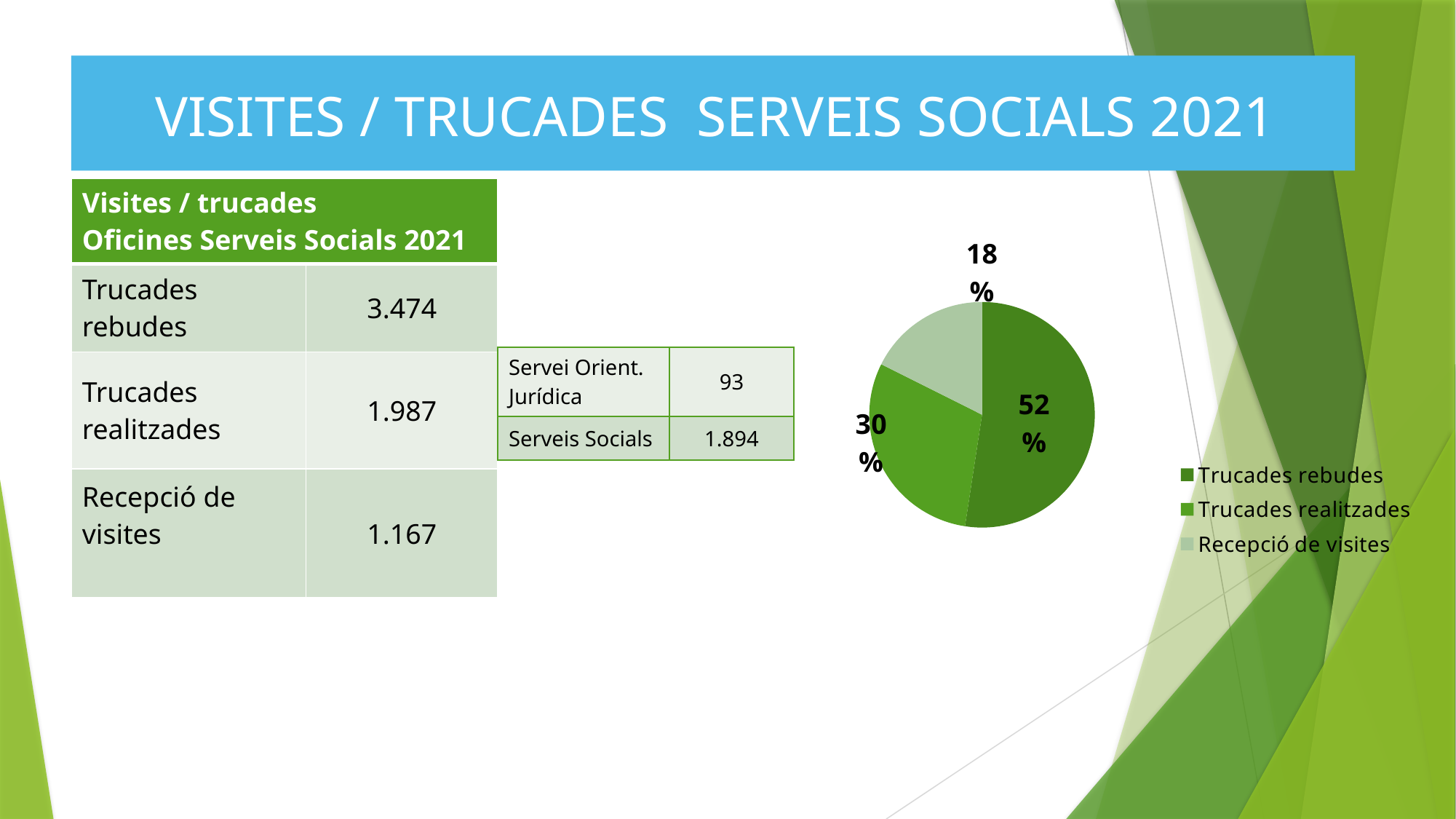
How many entries does the pie chart legend list? 3 How many slices does the pie chart have? 3 What percentage of the pie chart does Recepció de visites represent? 18% Which slice is larger in the pie chart, Trucades realitzades or Recepció de visites? Trucades realitzades Which legend entry of the pie chart is shown in the lightest green? Recepció de visites What is the difference in percentage points between the Trucades rebudes slice and the Trucades realitzades slice? 22 Which category has the largest slice in the pie chart? Trucades rebudes Is the share of the Trucades rebudes slice greater or less than 50%? greater What percentage of the pie chart does Trucades realitzades represent? 30% What kind of chart is shown on the slide? pie chart Which category has the smallest slice in the pie chart? Recepció de visites What percentage of the pie chart does Trucades rebudes represent? 52%